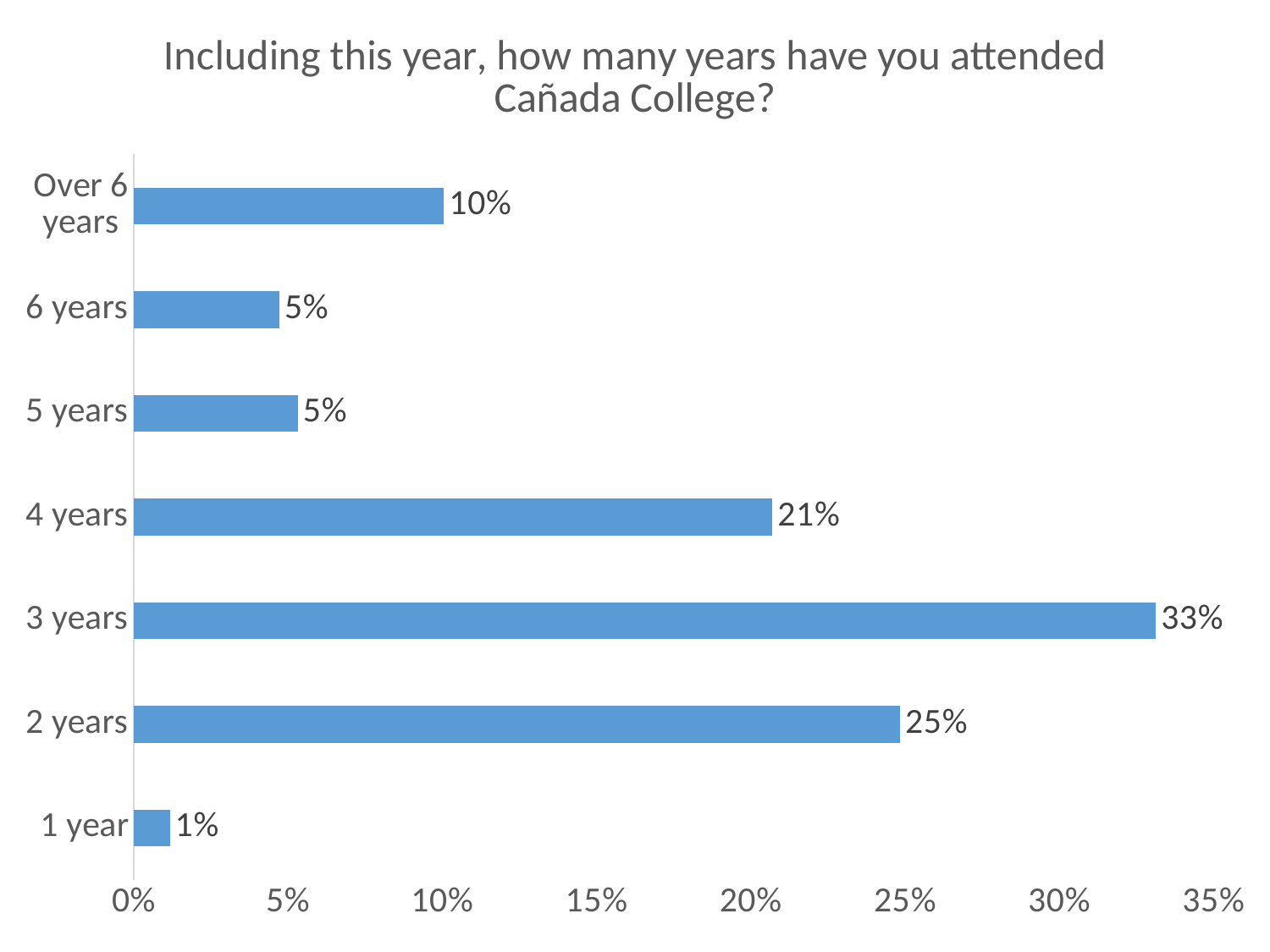
Which is larger, the value for 2 years or the value for 4 years? 2 years What percentage of respondents have attended Cañada College for 3 years? 33% What kind of chart is shown on the slide? Bar chart How many categories are shown on the chart? 7 Which category has the highest percentage? 3 years What is the value shown for the 'Over 6 years' category? 10% Is the value for 4 years greater or less than 20%? greater What is the difference between the percentages for 4 years and Over 6 years? 11% What percentage of respondents have attended for 1 year? 1% What is the difference between the percentages for 3 years and 2 years? 8% Which category has the lowest percentage? 1 year What is the title of the chart? Including this year, how many years have you attended Cañada College?